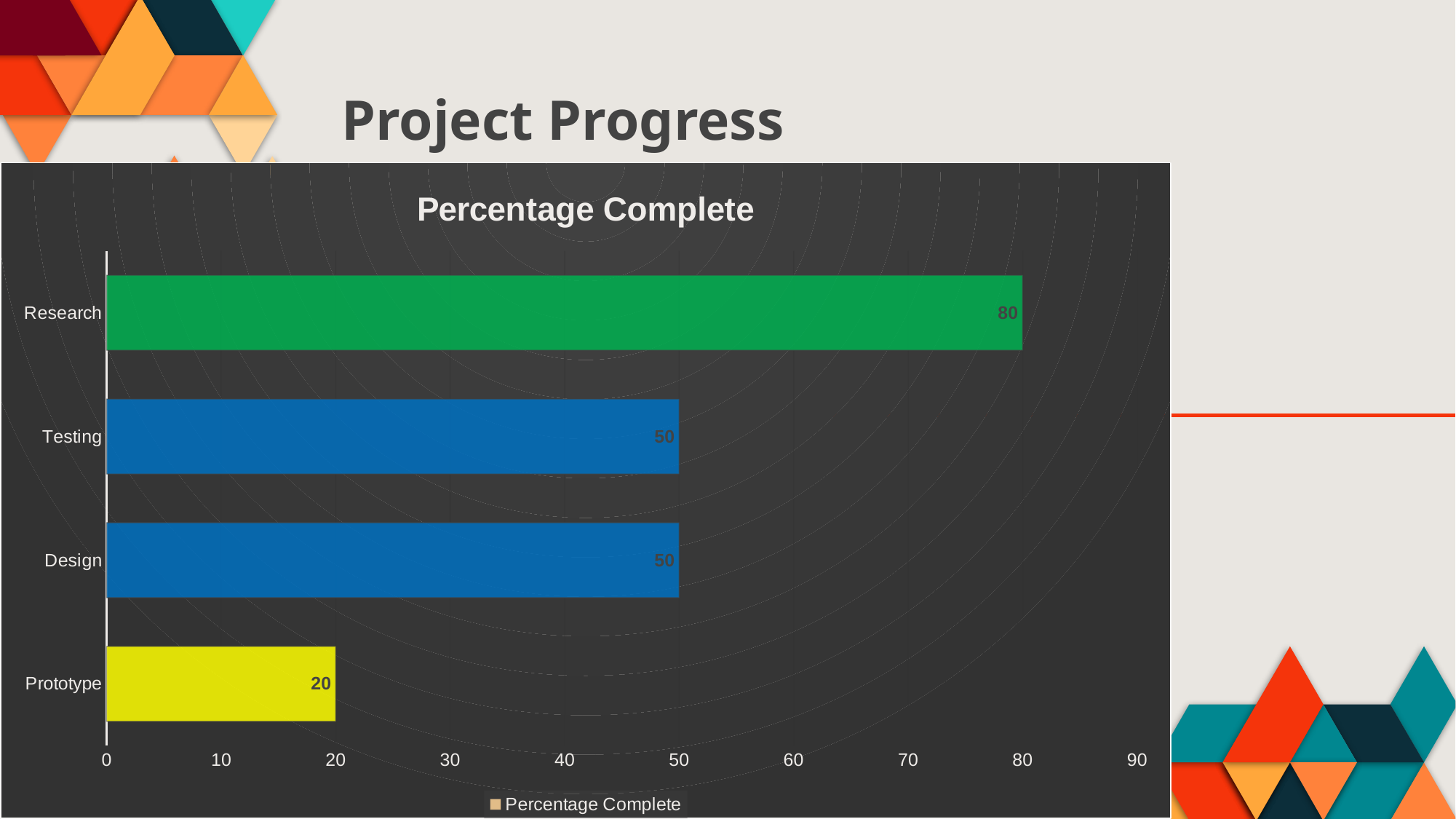
What kind of chart is shown on the slide? bar chart What is the title of the chart? Percentage Complete How many categories are shown in the chart? 4 Is the value for Research greater or less than 70? greater What is the difference between the values for Research and Prototype? 60 Which is larger, the value for Design or the value for Prototype? Design What is the difference between the values for Research and Design? 30 What is the value for Prototype? 20 What is the value for Research? 80 Which category has the lowest value? Prototype What is the value for Testing? 50 Which category has the highest value? Research